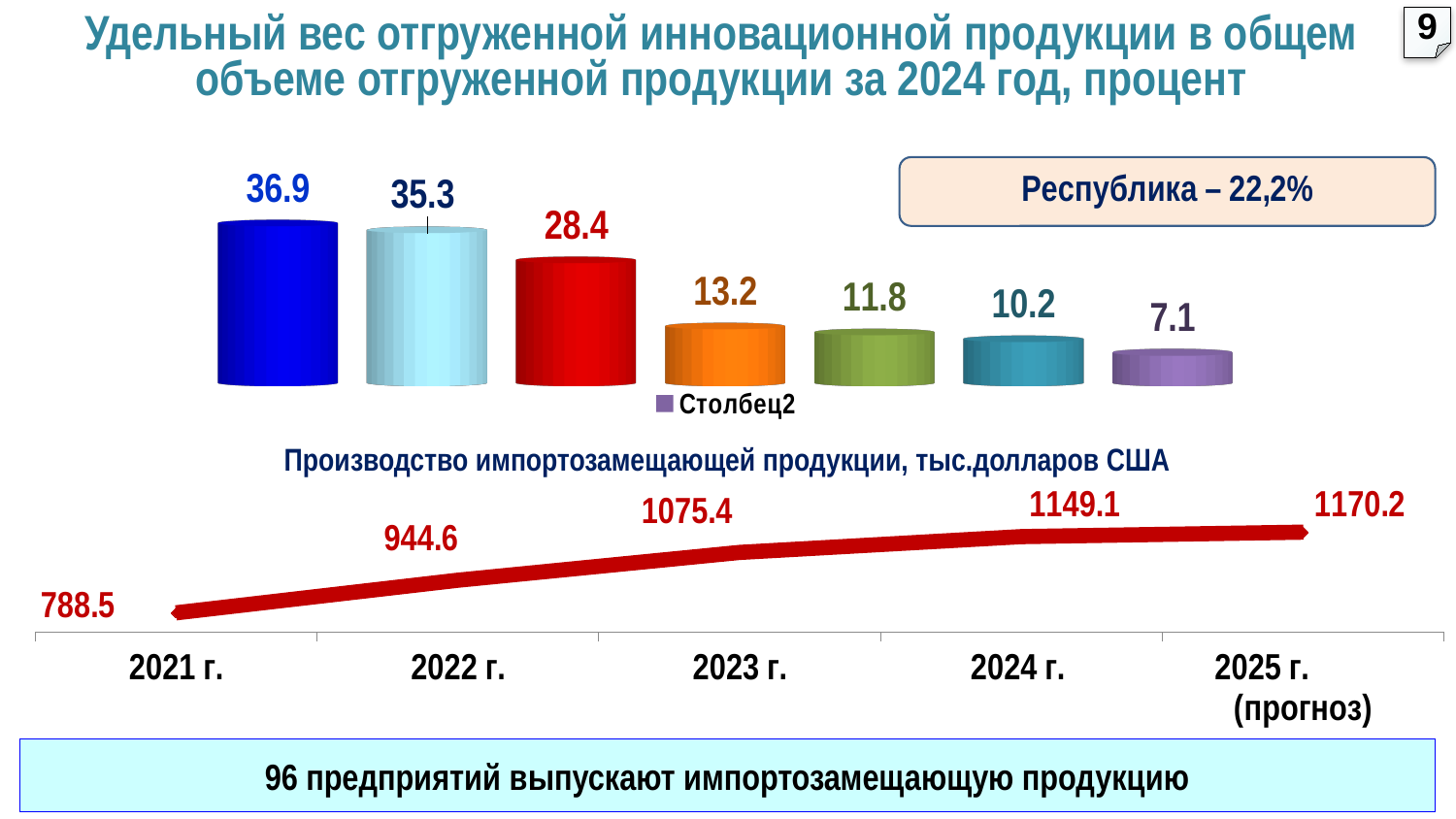
In the bottom chart 'Производство импортозамещающей продукции, тыс.долларов США', what is the difference between the values for 2024 г. and 2022 г.? 204.5 In the bottom chart 'Производство импортозамещающей продукции, тыс.долларов США', which year has the lowest value? 2021 г. In the bottom chart 'Производство импортозамещающей продукции, тыс.долларов США', what is the value for 2021 г.? 788.5 In the bottom chart 'Производство импортозамещающей продукции, тыс.долларов США', how many years are plotted? 5 What kind of chart is the bottom chart 'Производство импортозамещающей продукции, тыс.долларов США'? line chart In the bottom chart 'Производство импортозамещающей продукции, тыс.долларов США', do the values rise or fall from 2021 г. to 2025 г.? rise In the top bar chart, how many bars are there? 7 In the bottom chart 'Производство импортозамещающей продукции, тыс.долларов США', what is the value for 2025 г. (прогноз)? 1170.2 In the top bar chart, what is the lowest value shown? 7.1 In the top bar chart, what is the difference between the highest and lowest values? 29.8 In the top bar chart, what is the highest value shown? 36.9 In the bottom chart 'Производство импортозамещающей продукции, тыс.долларов США', what is the value for 2023 г.? 1075.4